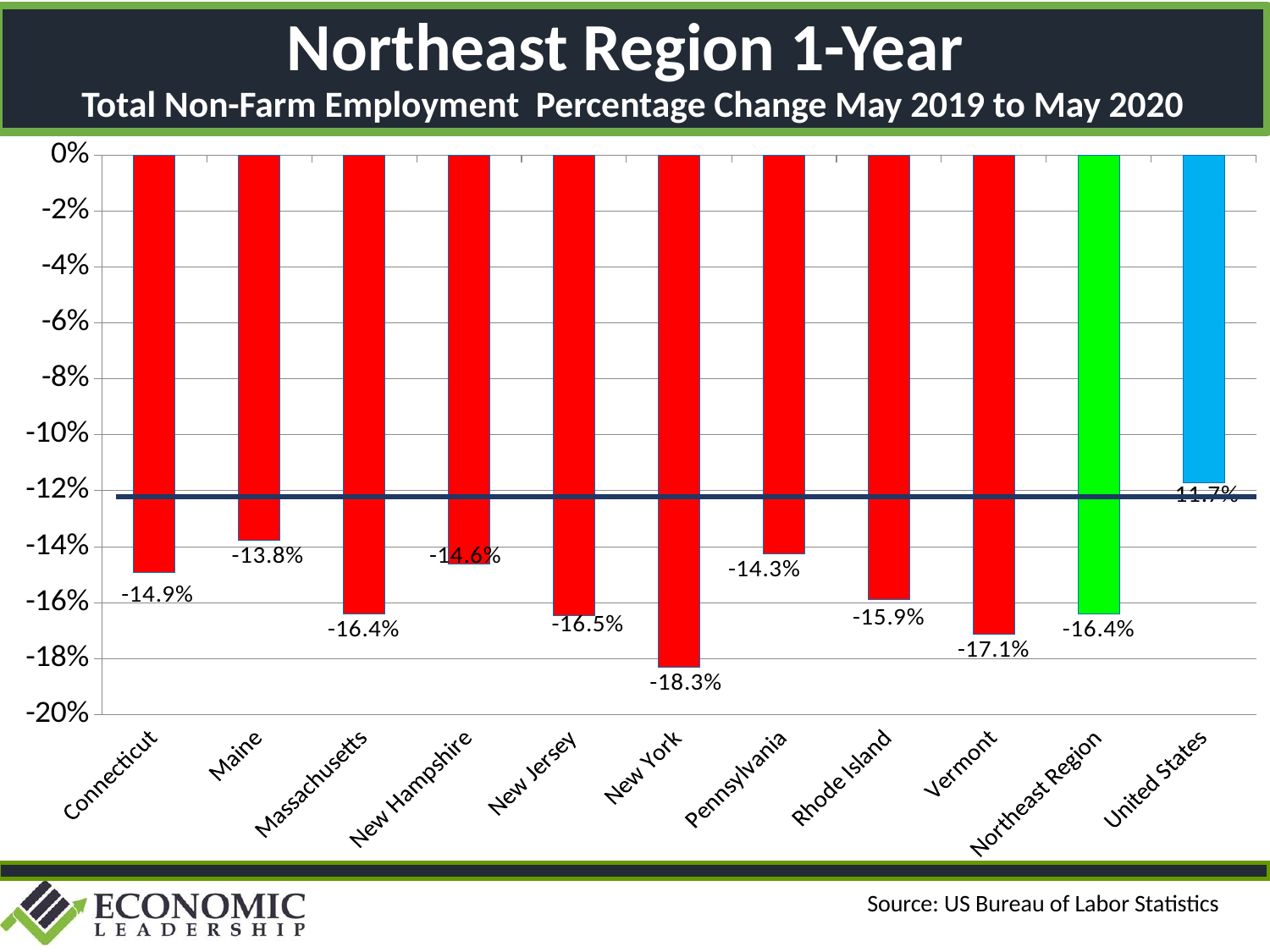
What kind of chart is shown on the slide? Bar chart What colour is the bar for the Northeast Region? Green What is the value shown for the Northeast Region bar? -16.4% What is the difference between the values for New York and Maine? 4.5 percentage points What is the value shown for Maine? -13.8% What is the difference between the values for Vermont and Connecticut? 2.2 percentage points What is the percentage change in total non-farm employment for New York? -18.3% Which state has the smallest decline (least negative value)? Maine Which has the larger decline, Rhode Island or Pennsylvania? Rhode Island How many categories are shown on the x axis? 11 Which category has the largest decline (most negative value)? New York What is the value shown for Vermont? -17.1%